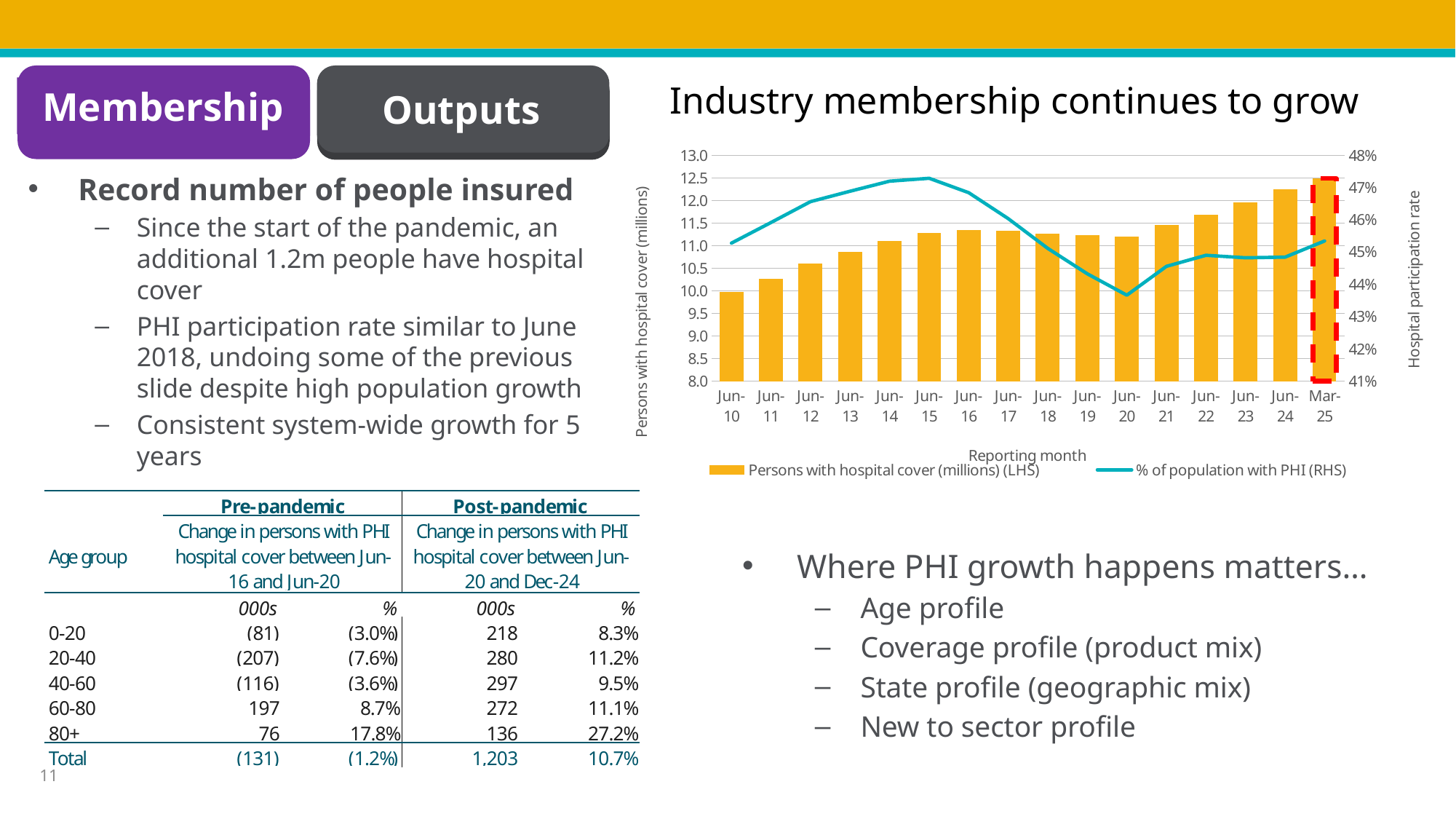
Is the persons with hospital cover value for Jun-16 greater or less than 11.5 million? less Which reporting month has the shortest bar for persons with hospital cover? Jun-10 Is the persons with hospital cover value for Jun-24 greater or less than 12.0 million? greater In which reporting month does the % of population with PHI line reach its highest point? Jun-15 How many series does the chart's legend list? 2 Does the % of population with PHI line rise or fall between Jun-15 and Jun-20? Fall How many reporting months are shown on the x axis of the chart? 16 Which has the taller bar for persons with hospital cover, Jun-22 or Jun-23? Jun-23 Is the % of population with PHI for Jun-21 greater or less than 45%? less Which reporting month has the tallest bar for persons with hospital cover? Mar-25 What kind of chart is shown under the title 'Industry membership continues to grow'? A combined bar and line chart In which reporting month does the % of population with PHI line reach its lowest point? Jun-20